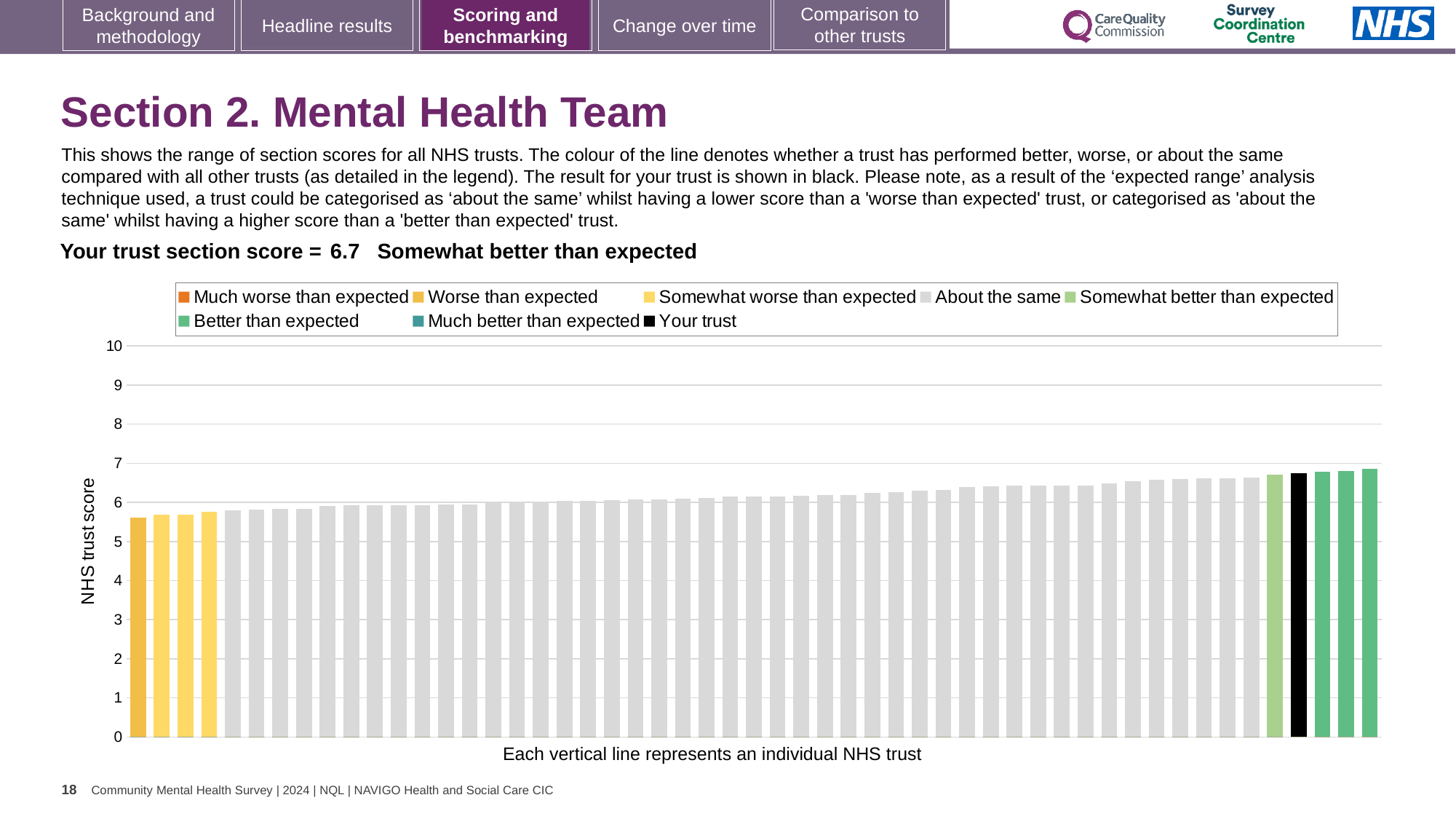
Is the value of the leftmost bar greater or less than 6? less Do the bar values rise or fall from left to right along the x axis? Rise Is the value for your trust greater or less than 5? greater How many entries does the chart legend list? 8 Which legend category does your trust's section score fall into? Somewhat better than expected What is the section score for your trust shown on the slide? 6.7 Is your trust's bar the highest bar on the chart? No What colour is the bar representing your trust? Black Which is larger, the leftmost bar or the bar for your trust? The bar for your trust What kind of chart is shown on the slide? Bar chart What is the label on the vertical axis of the chart? NHS trust score Is the value of the rightmost bar greater or less than 7? less